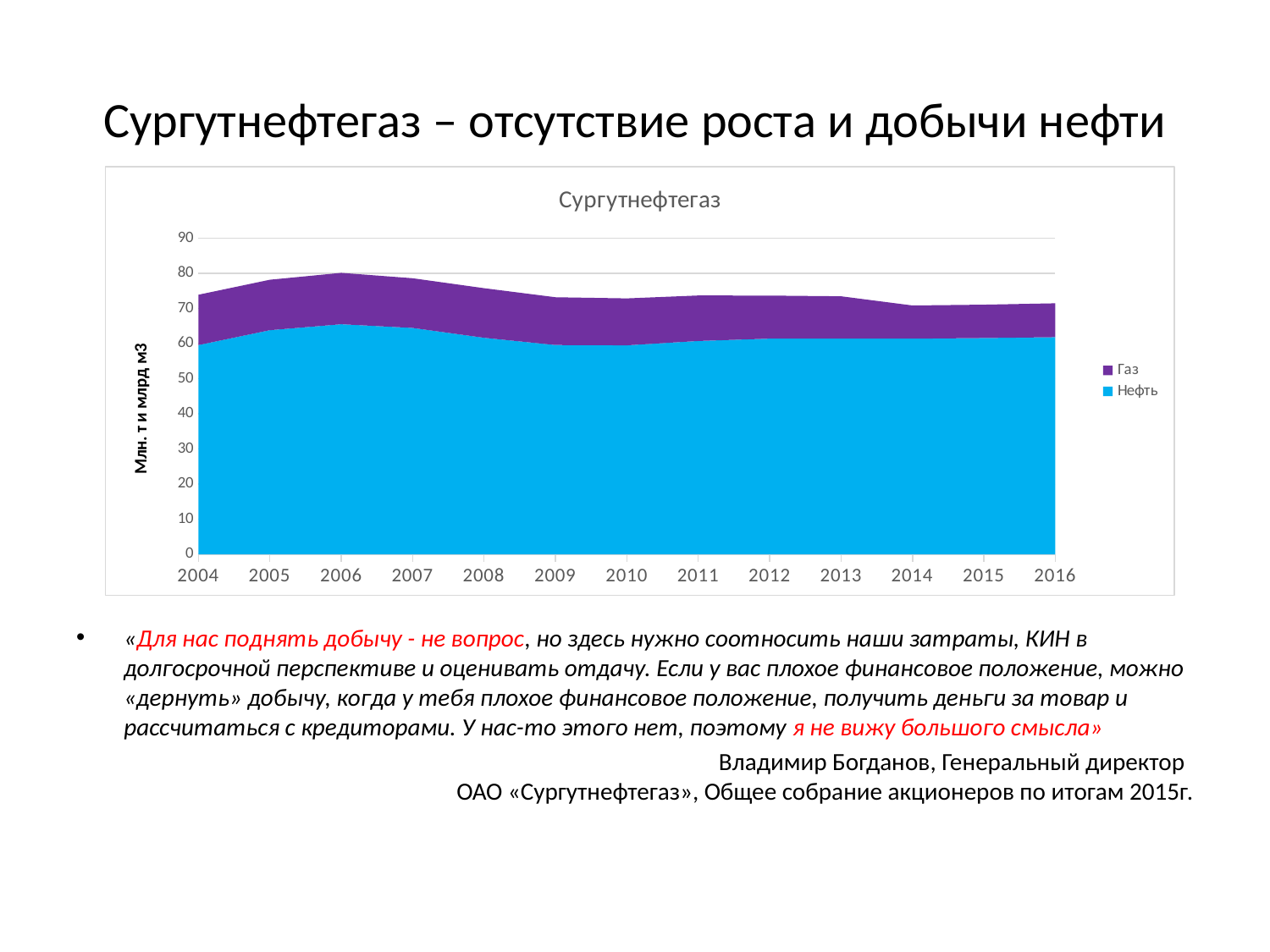
Which year has the larger Нефть value, 2006 or 2010? 2006 Is the combined total of Нефть and Газ for 2009 greater or less than 80? less How many years are shown along the x axis? 13 Does the Нефть value rise or fall from 2004 to 2006? rise What kind of chart is shown on the slide? Stacked area chart What is the label of the vertical axis? Млн. т и млрд м3 Is the combined total of Нефть and Газ for 2004 greater or less than 70? greater In which year is the combined total of Нефть and Газ highest? 2006 Is the Нефть value for 2006 greater or less than 60? greater In which year is the Нефть value highest? 2006 What is the title of the chart? Сургутнефтегаз How many series does the legend list? 2